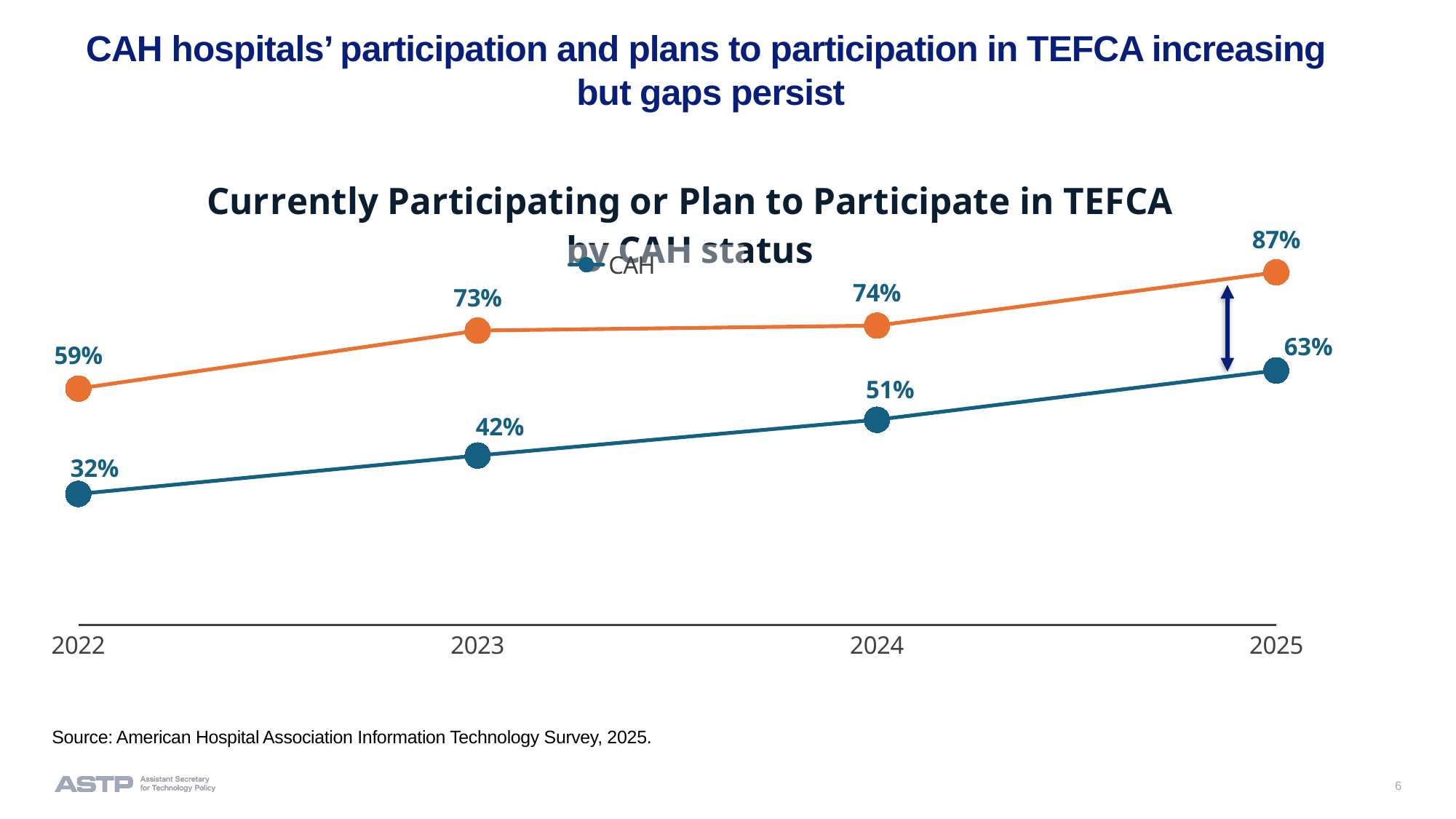
How many years are shown on the x axis? 4 In which year is the CAH value highest? 2025 What is the CAH value for 2025? 63% In which year is the orange line's value lowest? 2022 What kind of chart is shown on the slide? Line chart What is the value of the orange line in 2025? 87% Which is larger in 2024, the CAH value or the orange line's value? The orange line's value By how much did the CAH value increase from 2022 to 2025? 31 percentage points What is the difference between the orange line and the CAH line in 2025? 24 percentage points Does the CAH line rise or fall from 2022 to 2025? Rises What is the CAH value for 2022? 32% What is the value of the orange line in 2023? 73%